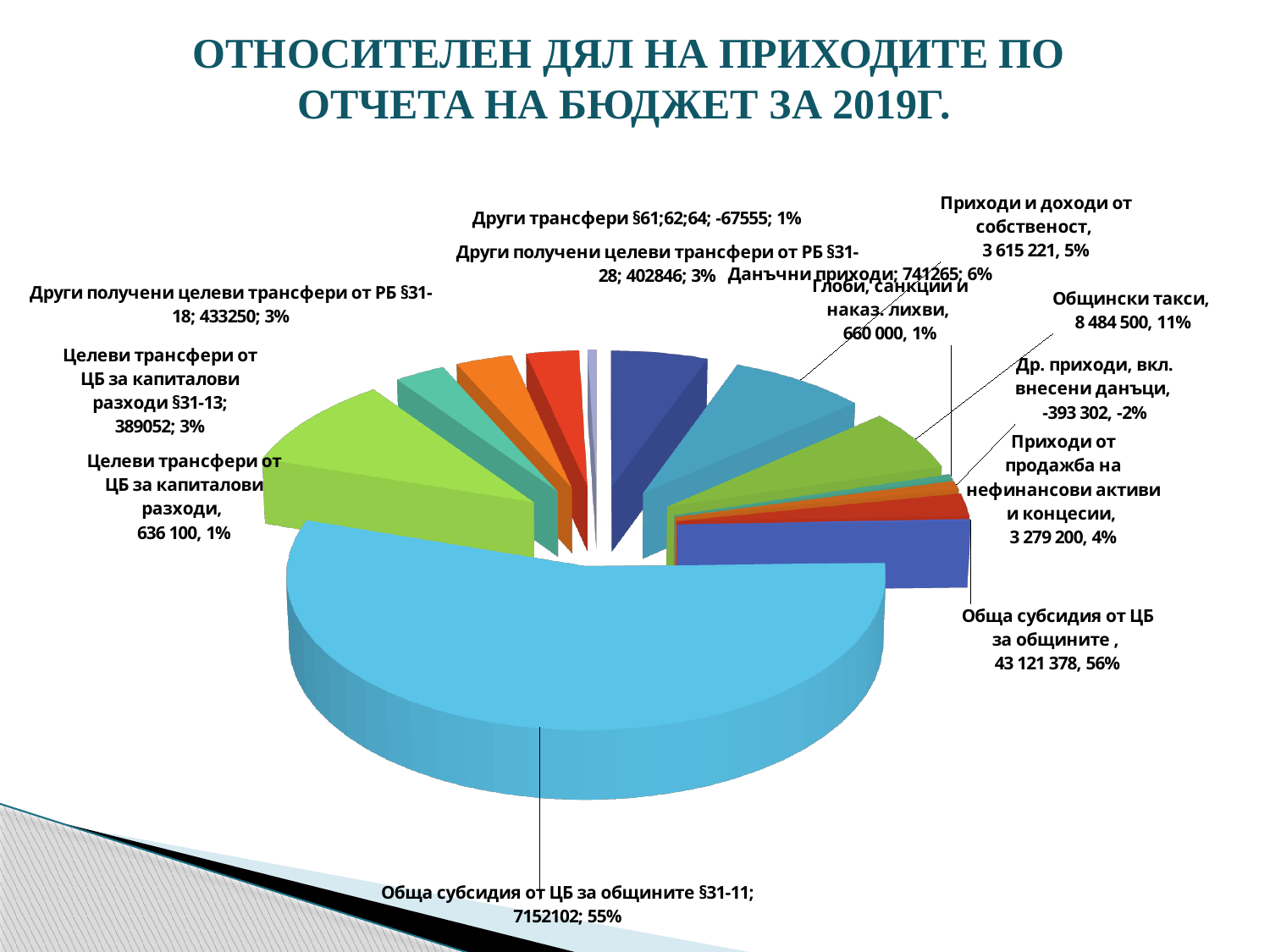
What share of the pie does Общински такси represent? 11% What value is shown for Приходи от продажба на нефинансови активи и концесии? 3 279 200 What percentage is shown for Данъчни приходи? 6% What is the title of the chart on the slide? ОТНОСИТЕЛЕН ДЯЛ НА ПРИХОДИТЕ ПО ОТЧЕТА НА БЮДЖЕТ ЗА 2019Г. What value and share are shown for Др. приходи, вкл. внесени данъци? -393 302, -2% What is the difference between the values for Общински такси and Приходи и доходи от собственост? 4 869 279 What value is shown for Други получени целеви трансфери от РБ §31-18? 433250 What value is shown for Глоби, санкции и наказ. лихви? 660 000 What type of chart is shown on the slide? Pie chart Which has the larger share: Общински такси or Данъчни приходи? Общински такси What value is shown for Общински такси? 8 484 500 What value is shown for Приходи и доходи от собственост? 3 615 221